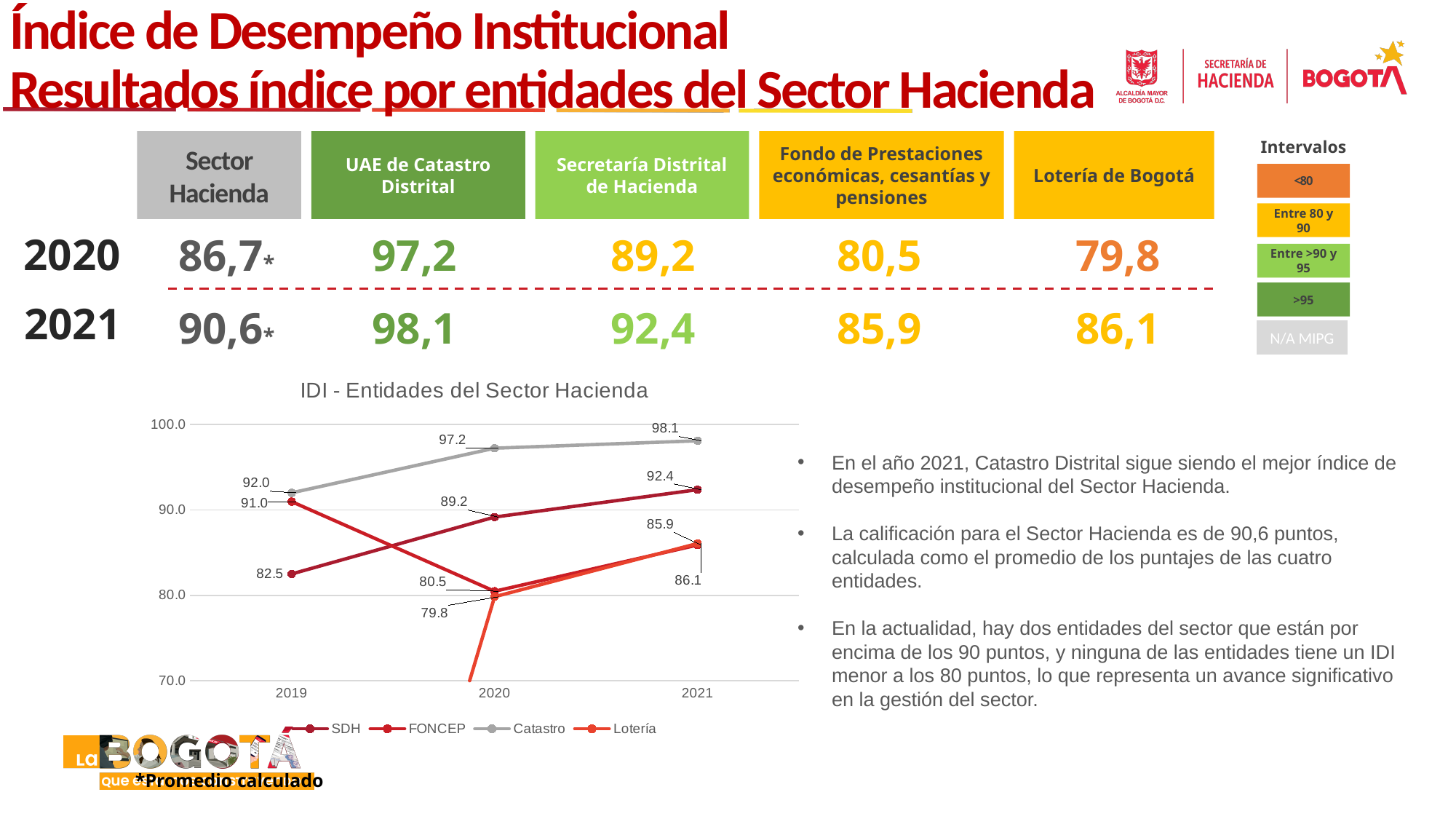
How many series does the legend of the 'IDI - Entidades del Sector Hacienda' chart list? 4 What kind of chart is 'IDI - Entidades del Sector Hacienda'? line chart In the 'IDI - Entidades del Sector Hacienda' chart, which series has the highest value in 2021? Catastro How many years are shown on the x axis of the 'IDI - Entidades del Sector Hacienda' chart? 3 In the 'IDI - Entidades del Sector Hacienda' chart, which series has the lowest value in 2020? Lotería In the 'IDI - Entidades del Sector Hacienda' chart, which is larger: SDH in 2020 or FONCEP in 2020? SDH in 2020 In the 'IDI - Entidades del Sector Hacienda' chart, what is the value for Catastro in 2021? 98.1 In the 'IDI - Entidades del Sector Hacienda' chart, what is the value for SDH in 2019? 82.5 In the 'IDI - Entidades del Sector Hacienda' chart, what is the value for Lotería in 2021? 86.1 In the 'IDI - Entidades del Sector Hacienda' chart, does the SDH series rise or fall from 2019 to 2021? rise In the 'IDI - Entidades del Sector Hacienda' chart, what is the value for FONCEP in 2020? 80.5 In the 'IDI - Entidades del Sector Hacienda' chart, what is the difference between Catastro's 2021 value and its 2019 value? 6.1